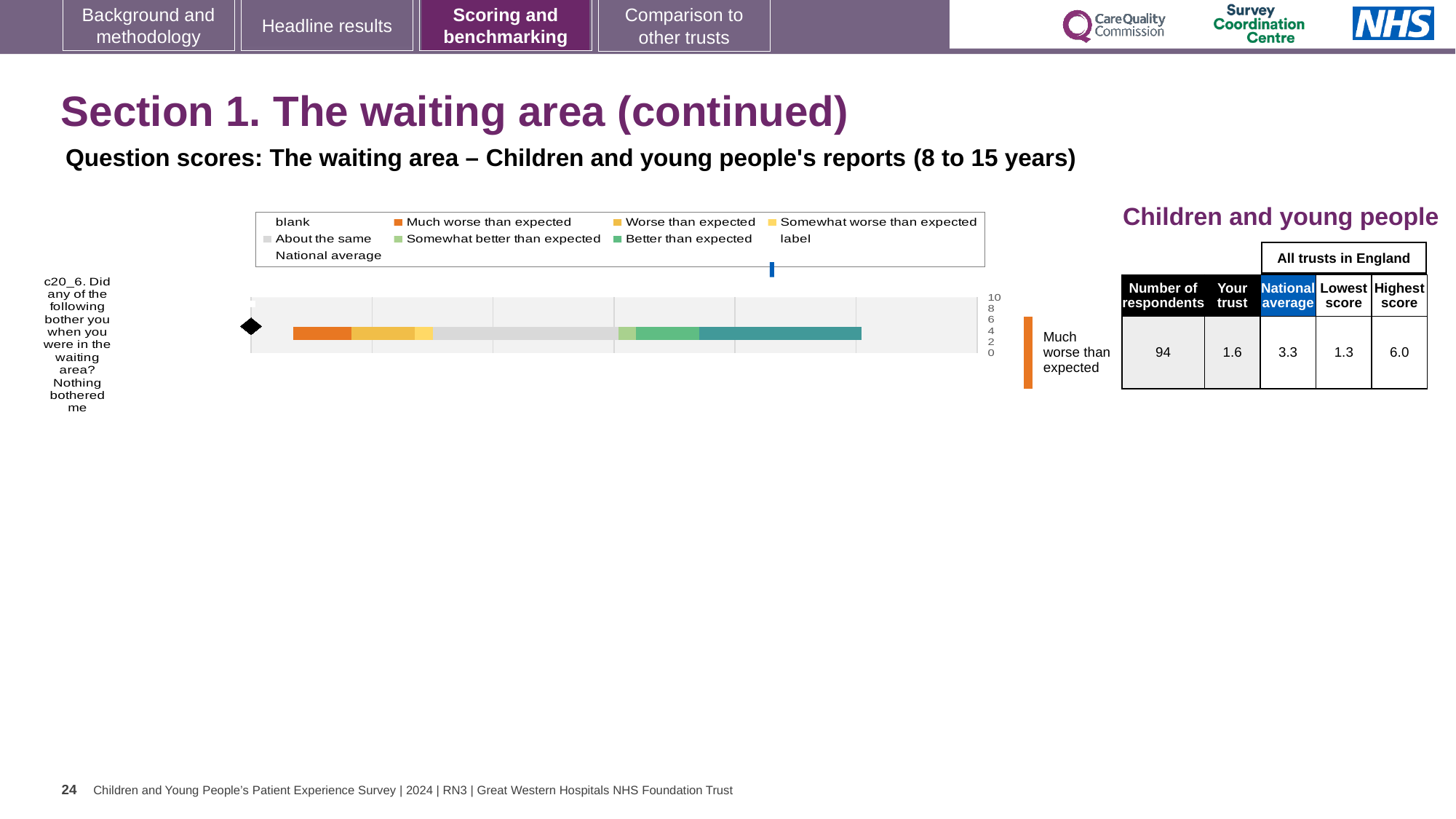
Which legend entry is shown in orange? Much worse than expected What kind of chart is shown on the slide? bar chart Which is larger for question c20_6, the trust score or the national average? national average What is the national average score for question c20_6? 3.3 What benchmark rating is shown next to the chart for question c20_6? Much worse than expected What is the 'Your trust' score for question c20_6? 1.6 How many questions (categories) are plotted in the bar chart? 1 What is the question code of the item plotted in the chart? c20_6 What is the number of respondents for question c20_6? 94 Which legend entry is shown in light grey? About the same How many entries does the chart legend list? 9 What is the difference between the highest score (6.0) and the lowest score (1.3) for question c20_6? 4.7